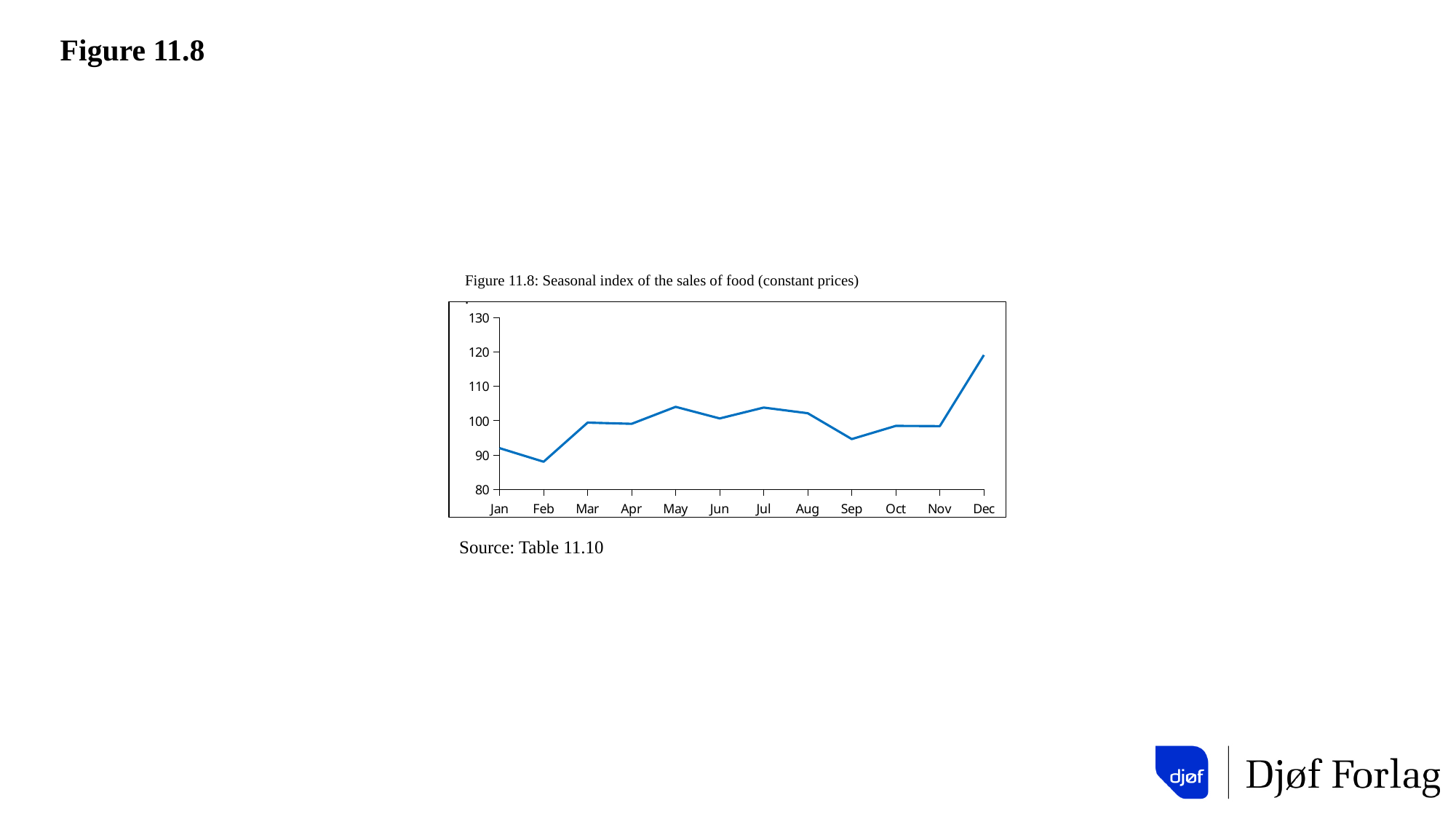
Is the value for Sep greater or less than 100? less Is the value for Feb greater or less than 90? less Does the seasonal index rise or fall from Nov to Dec? rise Is the value for Jan greater or less than 100? less How many months are plotted along the x axis? 12 What kind of chart is shown on the slide? line chart Which is larger, the value for Dec or the value for Jan? Dec What is the title of the chart? Figure 11.8: Seasonal index of the sales of food (constant prices) Which month has the highest seasonal index? Dec Which month has the lowest seasonal index? Feb Which is larger, the value for Mar or the value for Feb? Mar